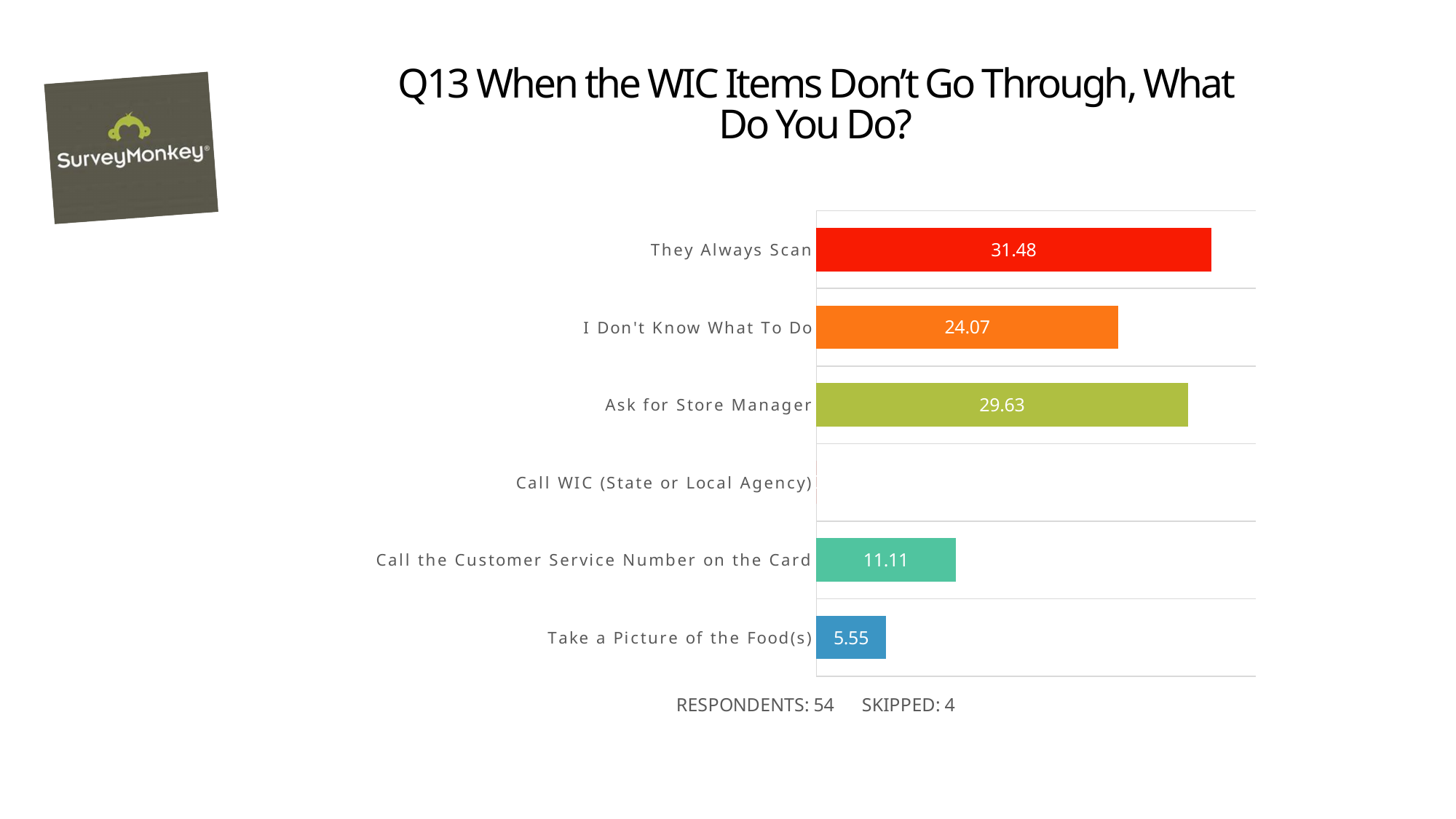
What is the value for "Take a Picture of the Food(s)"? 5.55 What is the value for "Ask for Store Manager"? 29.63 What is the difference between the values for "They Always Scan" and "I Don't Know What To Do"? 7.41 What is the value for "I Don't Know What To Do"? 24.07 What is the value for "They Always Scan"? 31.48 What is the difference between the values for "Ask for Store Manager" and "Call the Customer Service Number on the Card"? 18.52 What is the value for "Call the Customer Service Number on the Card"? 11.11 How many respondents does the slide report for this question? 54 How many categories are shown on the chart? 6 What kind of chart is shown on the slide? Bar chart Which is larger, the value for "Ask for Store Manager" or the value for "I Don't Know What To Do"? Ask for Store Manager Which category has the highest value? They Always Scan